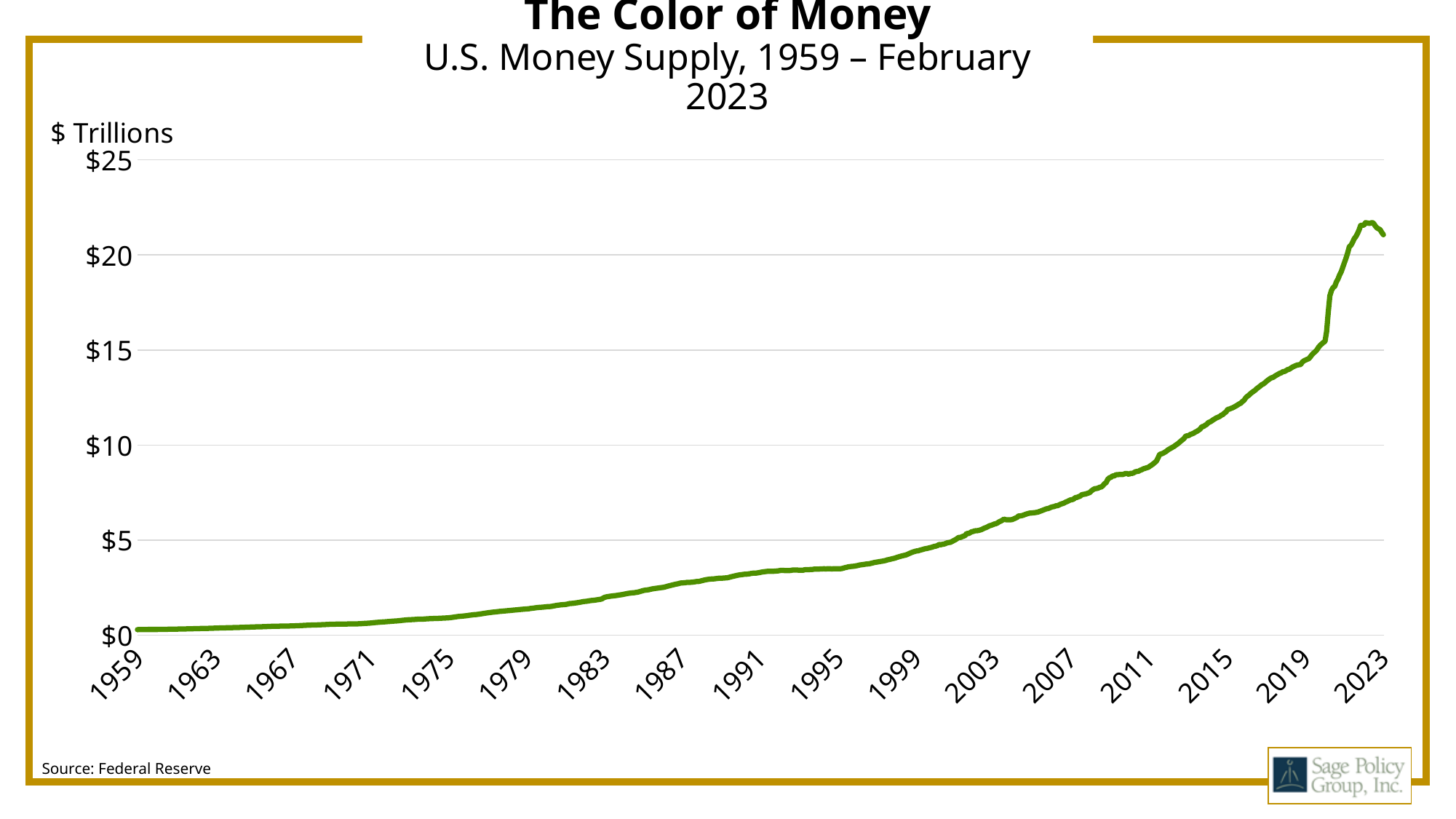
Is the value for 1983 greater or less than $5? less Which labelled year on the x axis has the lowest money supply? 1959 What unit is the vertical axis measured in? $ Trillions Which labelled year on the x axis has the highest money supply? 2023 Is the value for 2007 greater or less than $10? less Is the value for 2023 greater or less than $20? greater Does the money supply generally rise or fall from 1959 to 2023? rise What kind of chart is shown on the slide? line chart What is the title of the chart? The Color of Money How many year labels are shown on the x axis? 17